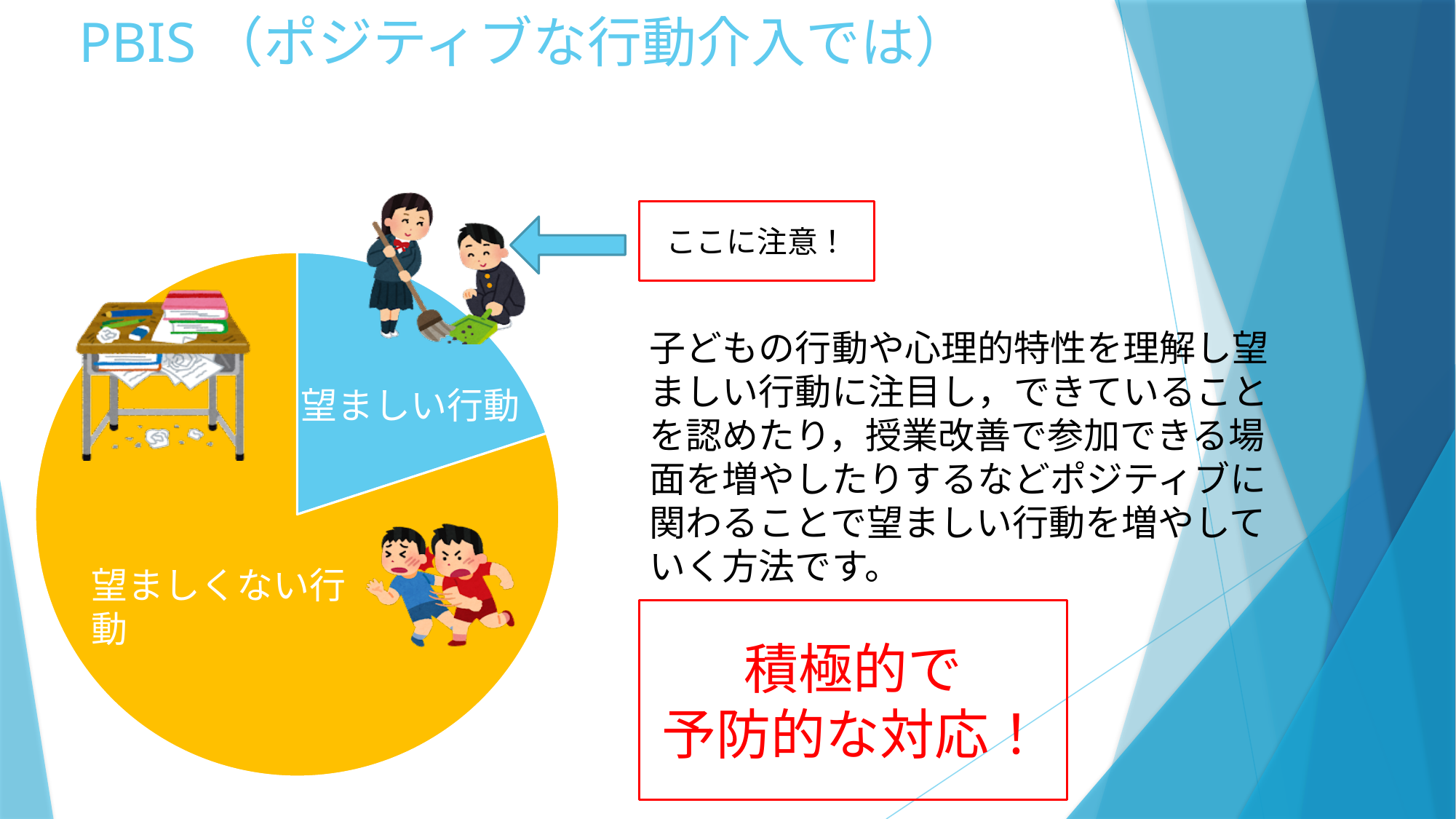
Which slice of the pie chart does the arrow labelled ここに注意！ point to? 望ましい行動 Which slice of the pie chart is the smallest? 望ましい行動 How many slices does the pie chart have? 2 Which slice is larger, 望ましい行動 or 望ましくない行動? 望ましくない行動 What kind of chart is shown on the slide? pie chart What colour is the 望ましい行動 slice of the pie chart? blue Which slice of the pie chart is the largest? 望ましくない行動